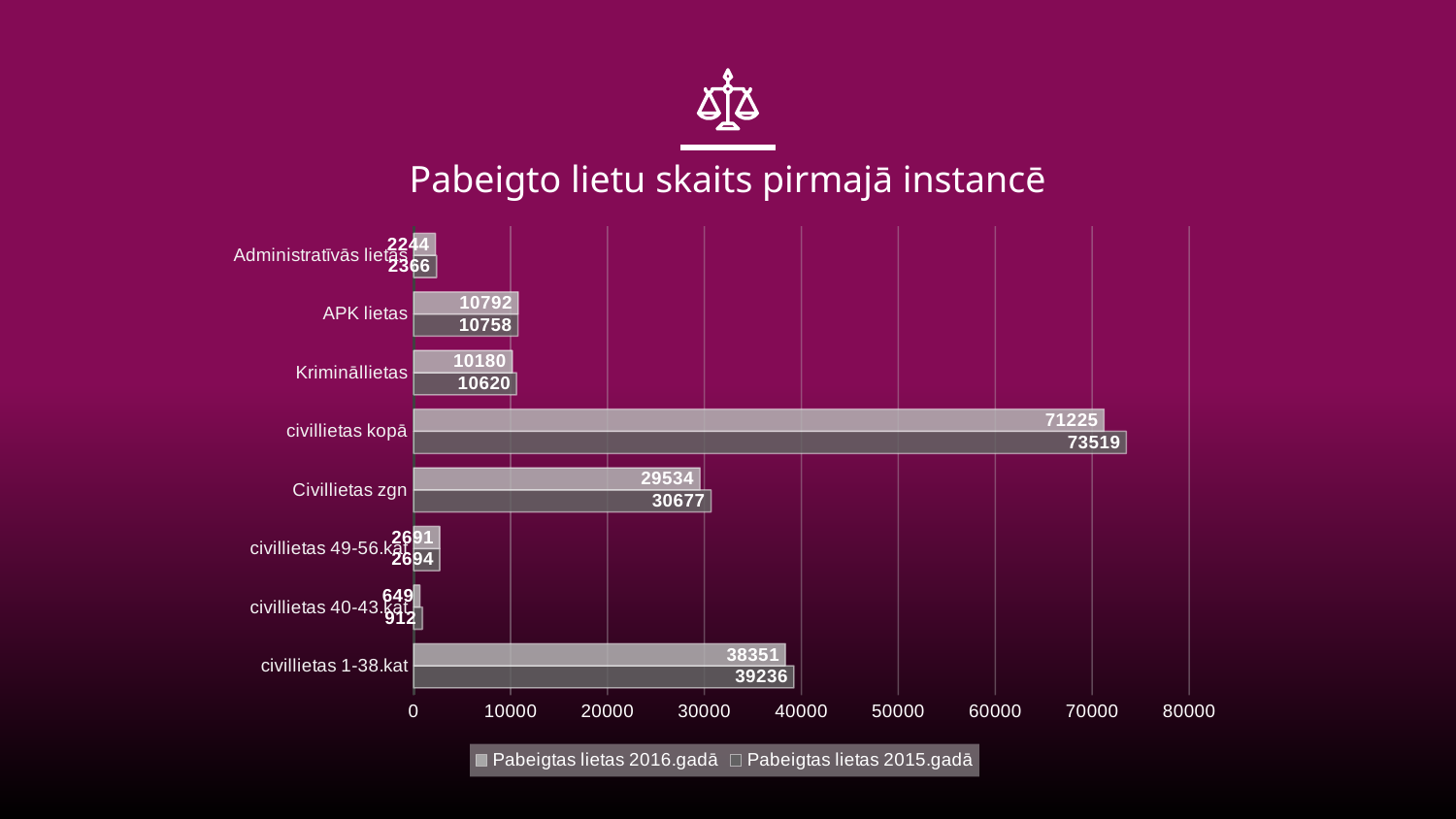
What is the difference between the two values shown for civillietas kopā (73519 and 71225)? 2294 Which is larger: the upper bar for APK lietas or the upper bar for Krimināllietas? APK lietas What type of chart is shown on the slide? bar chart What is the value of the upper (lighter) bar for civillietas kopā? 71225 Which category has the lowest values in the chart? civillietas 40-43.kat Are the values for civillietas 1-38.kat greater or less than 30000? greater How many series does the legend list? 2 What is the difference between the two values shown for Civillietas zgn (30677 and 29534)? 1143 What is the title of the chart? Pabeigto lietu skaits pirmajā instancē How many categories are shown on the vertical axis of the chart? 8 Which category has the highest values in the chart? civillietas kopā What is the value of the lower (darker) bar for civillietas 1-38.kat? 39236